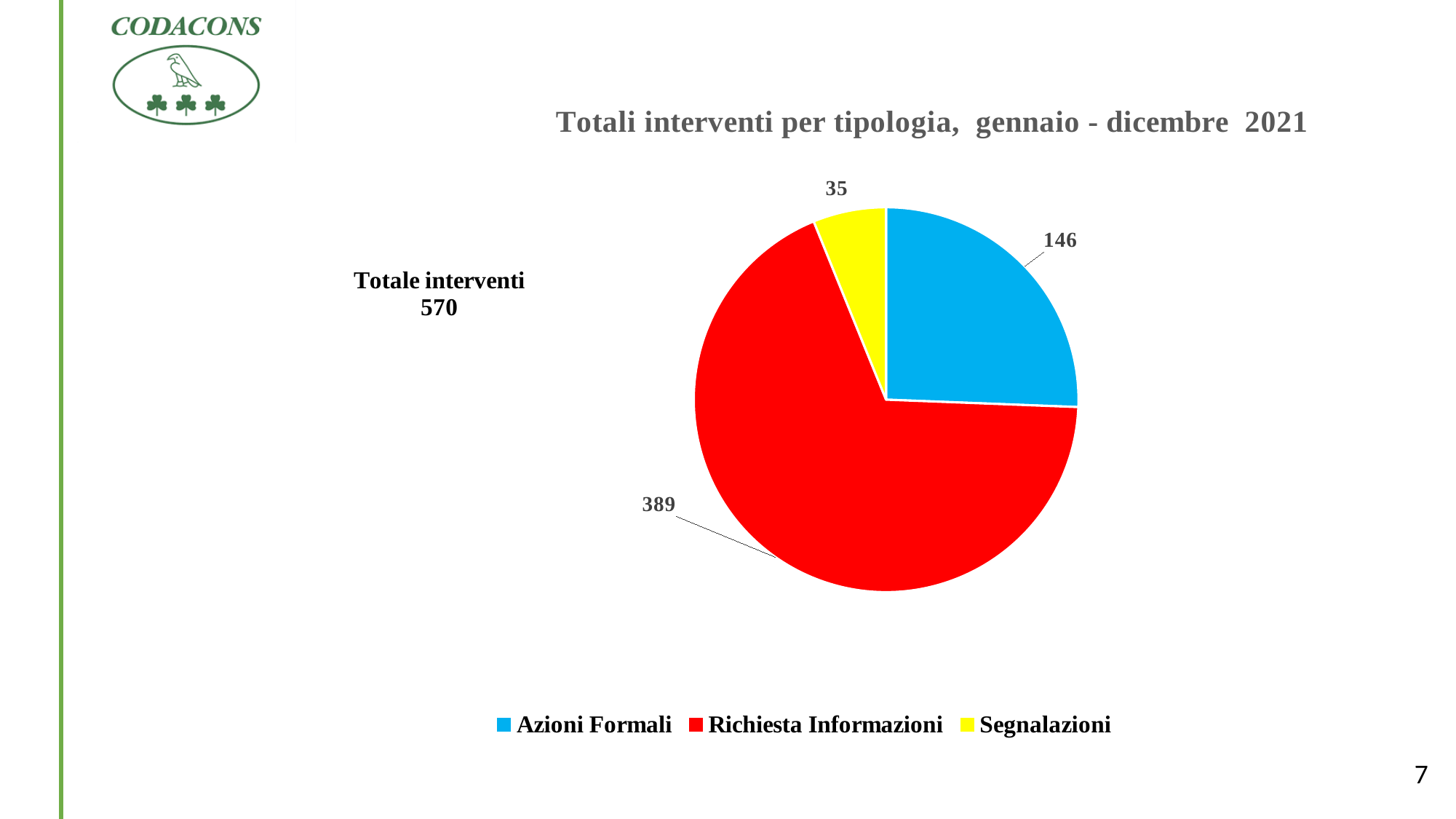
What is the total of all slices in the pie chart (Totale interventi)? 570 Which category has the smallest slice of the pie? Segnalazioni What is the value for Azioni Formali? 146 How many categories does the pie chart have? 3 What is the title of the chart? Totali interventi per tipologia, gennaio - dicembre 2021 Which category has the largest slice of the pie? Richiesta Informazioni What is the value for Richiesta Informazioni? 389 What is the difference between Azioni Formali and Segnalazioni? 111 What type of chart is shown on the slide? pie chart Which is larger, Azioni Formali or Segnalazioni? Azioni Formali What is the value for Segnalazioni? 35 What is the difference between Richiesta Informazioni and Azioni Formali? 243